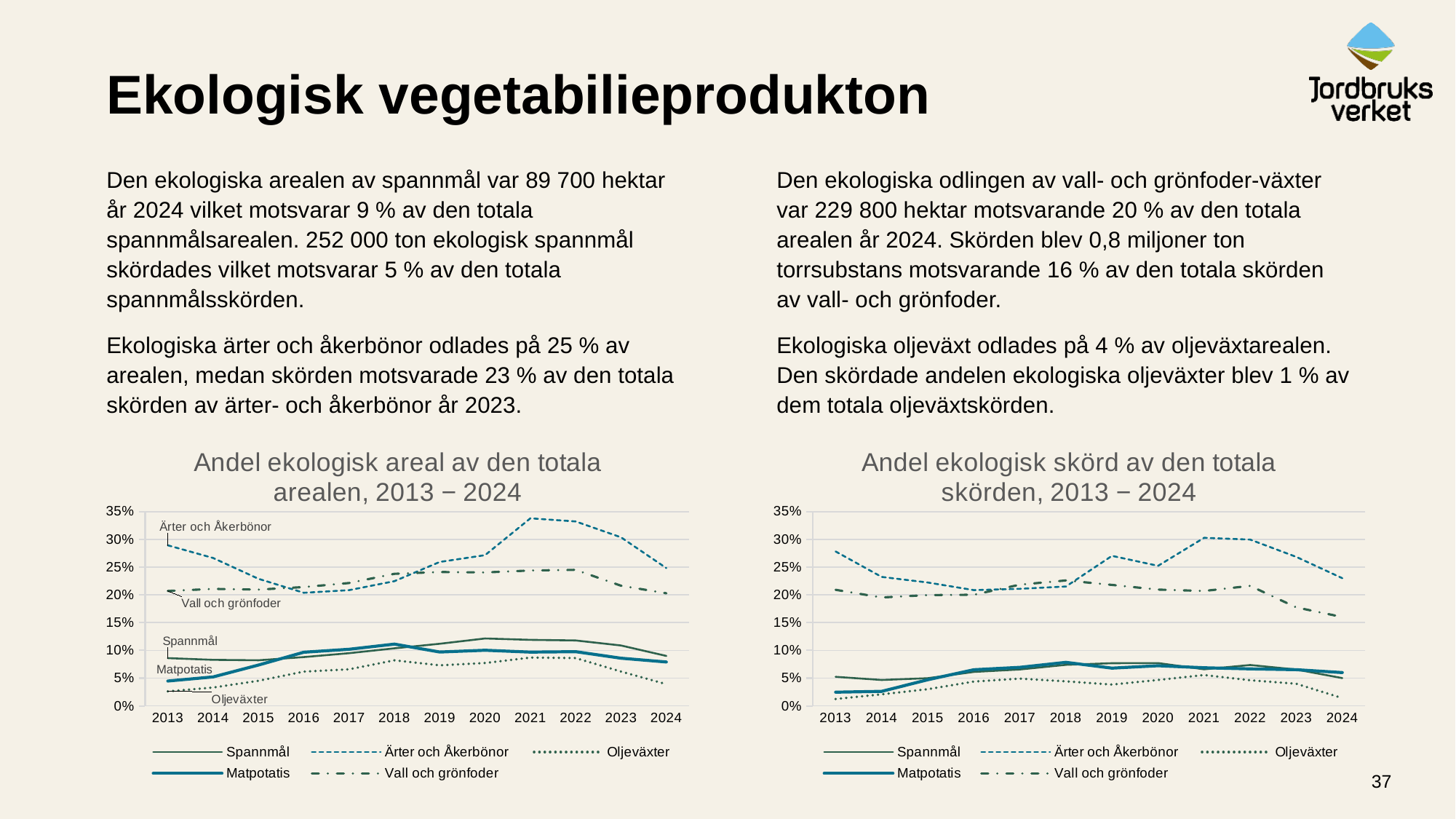
In the right chart, 'Andel ekologisk skörd av den totala skörden', is the value for Ärter och Åkerbönor in 2013 greater or less than 25%? greater In the left chart, 'Andel ekologisk areal av den totala arealen', is the value for Oljeväxter in 2013 greater or less than 5%? less In the left chart, 'Andel ekologisk areal av den totala arealen', which is larger in 2013: Ärter och Åkerbönor or Vall och grönfoder? Ärter och Åkerbönor In the right chart, 'Andel ekologisk skörd av den totala skörden', which series has the highest value in 2021? Ärter och Åkerbönor In the right chart, 'Andel ekologisk skörd av den totala skörden', is the value for Vall och grönfoder in 2024 greater or less than 20%? less In the left chart, 'Andel ekologisk areal av den totala arealen', which series has the lowest value in 2024? Oljeväxter In the left chart, 'Andel ekologisk areal av den totala arealen', which series has the highest value in 2021? Ärter och Åkerbönor What kind of chart is the left chart, 'Andel ekologisk areal av den totala arealen, 2013 − 2024'? Line chart How many series does the legend of the right chart, 'Andel ekologisk skörd av den totala skörden, 2013 − 2024', list? 5 How many years are shown on the x axis of the left chart, 'Andel ekologisk areal av den totala arealen'? 12 In the right chart, 'Andel ekologisk skörd av den totala skörden', does the value for Ärter och Åkerbönor rise or fall from 2021 to 2024? Fall